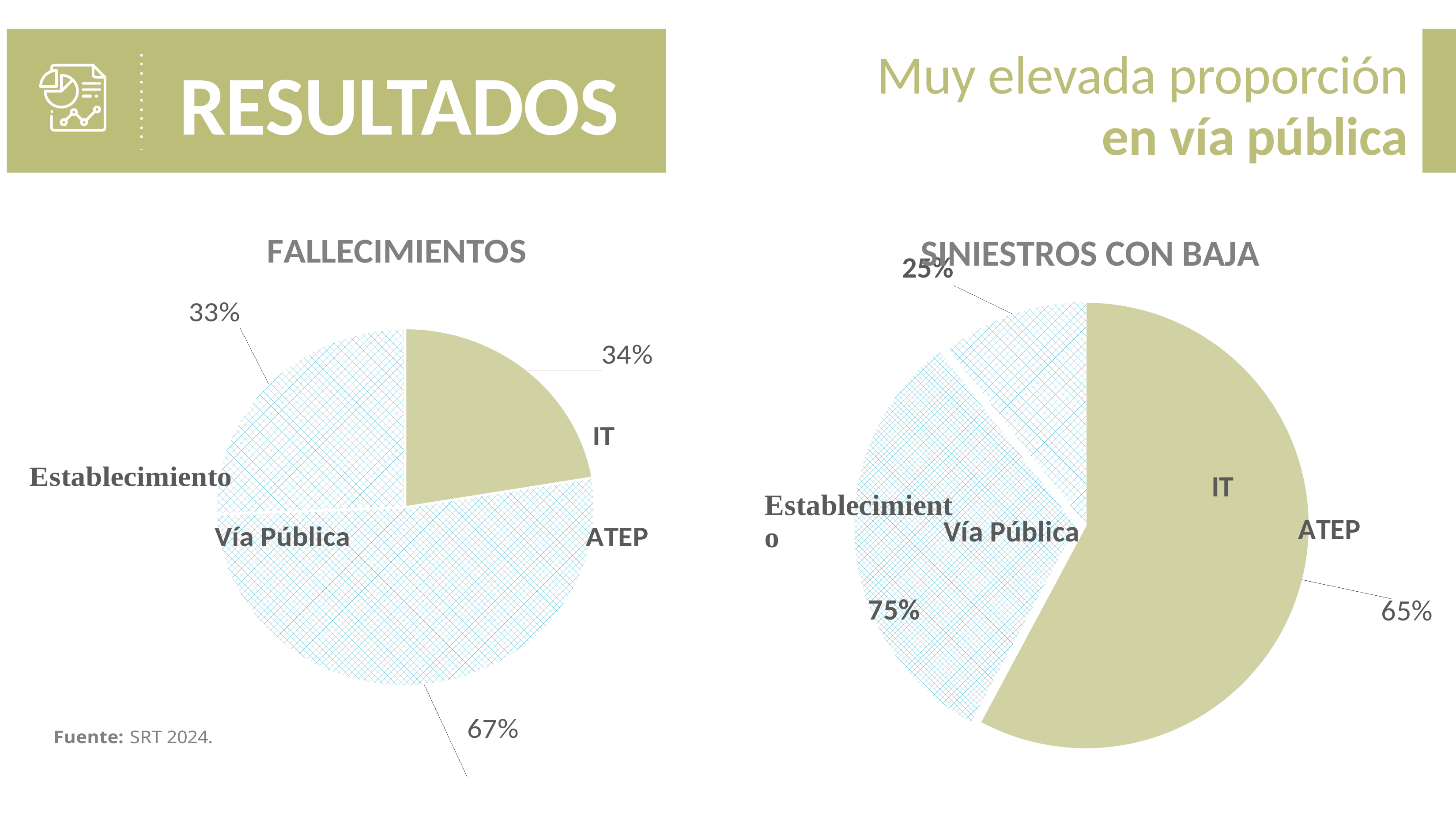
What kind of chart is the FALLECIMIENTOS chart? pie chart What is the title of the chart on the left of the slide? FALLECIMIENTOS In the FALLECIMIENTOS chart, what percentage label is shown next to Vía Pública? 67% In the SINIESTROS CON BAJA chart, what percentage label is shown for Establecimiento? 25% In the FALLECIMIENTOS chart, what percentage is shown for the IT slice? 34% In the SINIESTROS CON BAJA chart, what is the difference between the Vía Pública label and the Establecimiento label? 50% How many charts are shown on the slide? 2 What kind of chart is the SINIESTROS CON BAJA chart? pie chart In the SINIESTROS CON BAJA chart, what percentage is shown next to ATEP? 65% In the SINIESTROS CON BAJA chart, what percentage label is shown next to Vía Pública? 75% In the FALLECIMIENTOS chart, what percentage label is shown next to Establecimiento? 33% In the FALLECIMIENTOS chart, which has the larger percentage label, Vía Pública or Establecimiento? Vía Pública